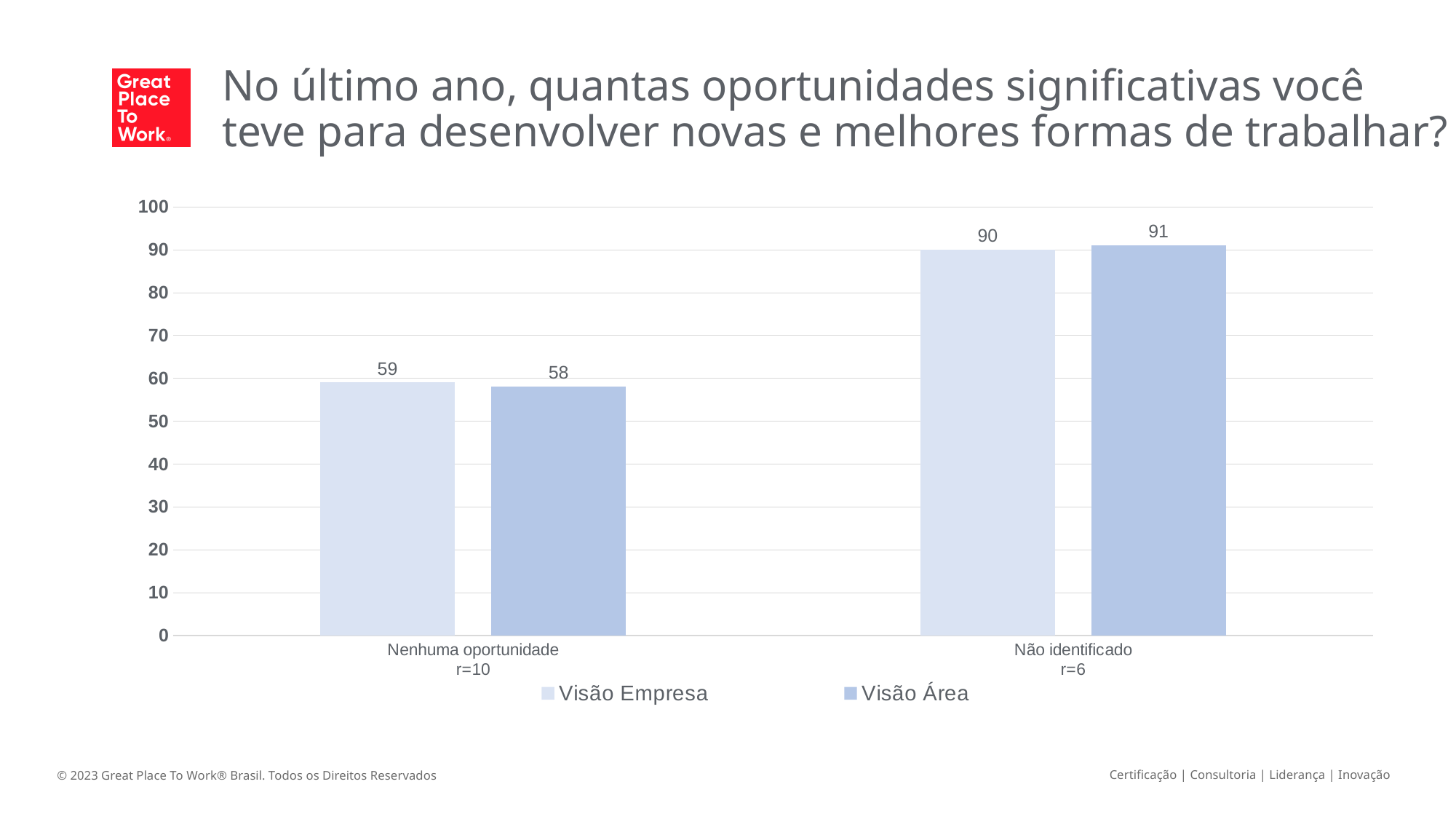
What is the Visão Empresa value for Não identificado? 90 What is the Visão Empresa value for Nenhuma oportunidade? 59 How many series does the legend list? 2 What kind of chart is shown on the slide? Bar chart What is the difference between the Visão Área and Visão Empresa values for Não identificado? 1 How many categories are shown on the x axis? 2 Which category has the lowest Visão Empresa value? Nenhuma oportunidade What is the difference between the Visão Empresa values for Não identificado and Nenhuma oportunidade? 31 What is the Visão Área value for Não identificado? 91 Which category has the highest Visão Área value? Não identificado What is the Visão Área value for Nenhuma oportunidade? 58 Which is larger: the Visão Empresa value for Não identificado or the Visão Empresa value for Nenhuma oportunidade? Não identificado